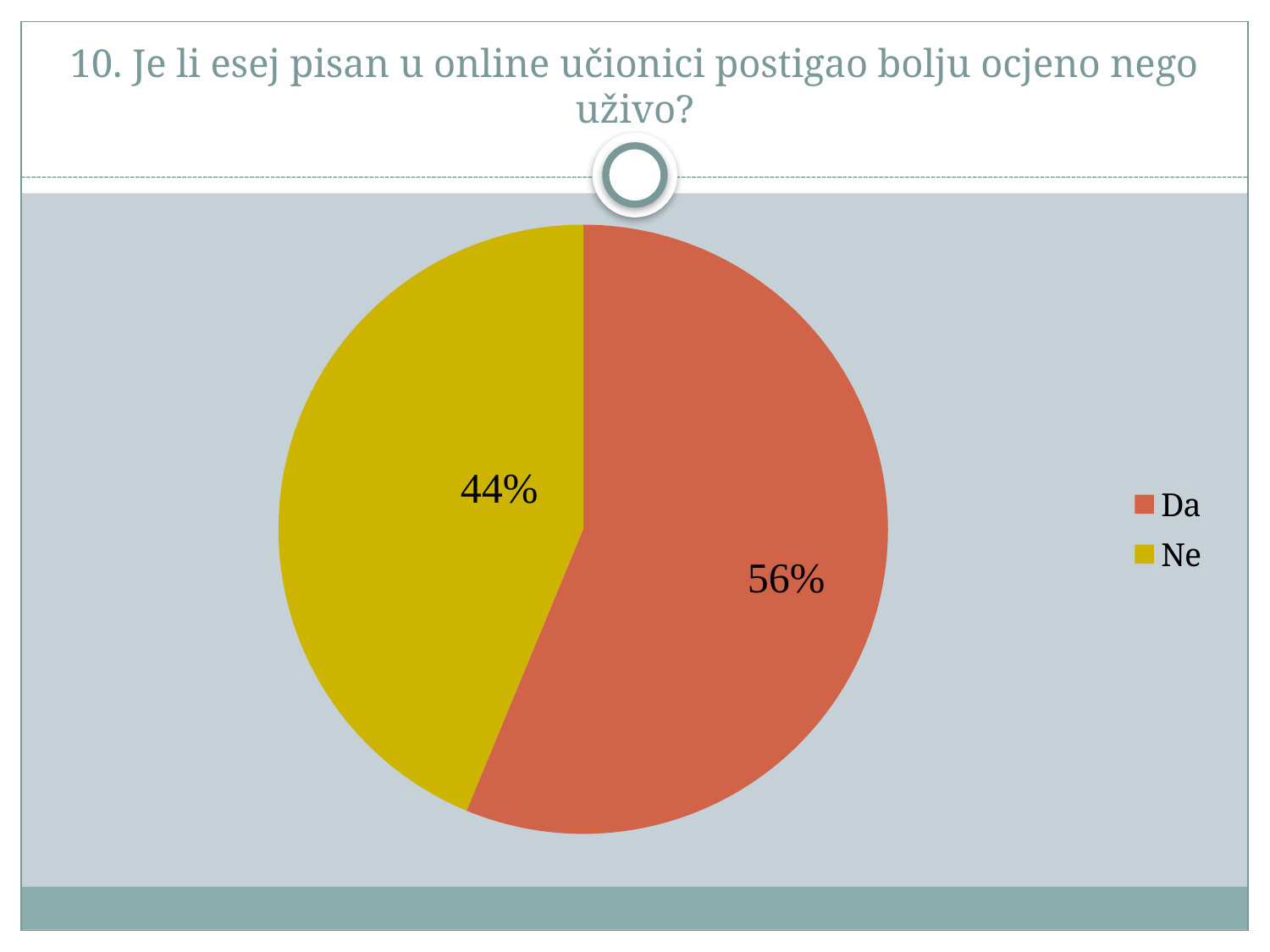
How many slices does the pie chart have? 2 What percentage of the pie chart is labelled "Da"? 56% What share of the pie does the "Ne" slice represent? 44% What is the difference in percentage points between the "Da" and "Ne" slices? 12 What kind of chart is shown on the slide? Pie chart What colour is the "Ne" slice in the pie chart? Yellow Which category has the largest share of the pie chart? Da Which category has the smallest share of the pie chart? Ne What percentage of the pie chart is labelled "Ne"? 44% Which slice is larger, "Da" or "Ne"? Da What colour is the "Da" slice in the pie chart? Red How many entries does the legend list? 2